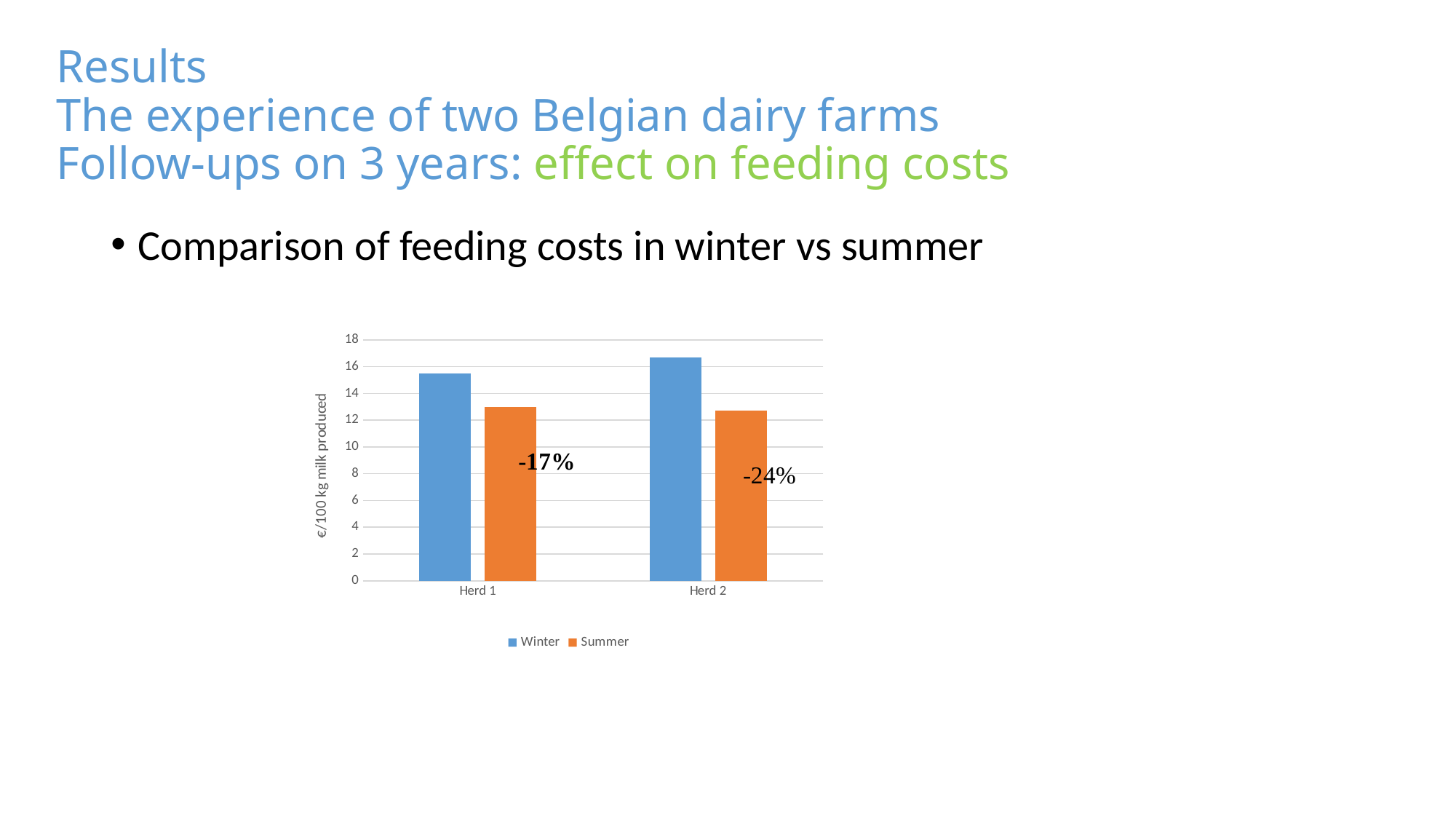
What kind of chart is shown on the slide? Bar chart What percentage change is printed next to the Summer bar for Herd 1? -17% How many herds (categories) are shown on the x axis? 2 Is the Summer value for Herd 2 greater or less than 14? less Is the Winter value for Herd 2 greater or less than 16? greater Which herd has the larger Winter feeding cost, Herd 1 or Herd 2? Herd 2 Is the Winter value for Herd 1 greater or less than 14? greater Which bar is the highest in the chart? Herd 2 Winter What is the label on the vertical axis of the chart? €/100 kg milk produced How many series does the legend list? 2 For Herd 1, which is larger: the Winter value or the Summer value? Winter What percentage change is printed next to the Summer bar for Herd 2? -24%